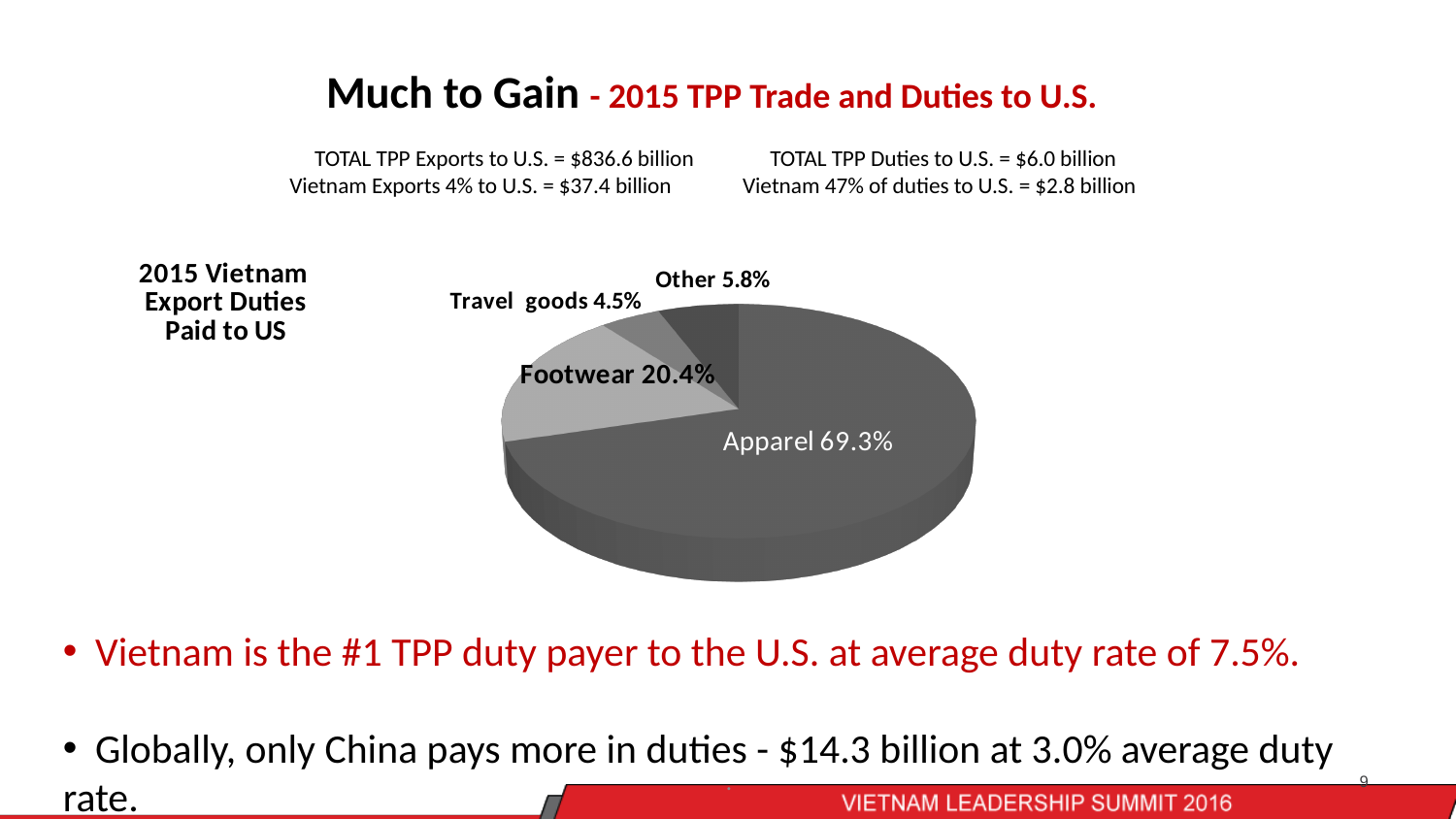
What share of the pie does Other represent? 5.8% What is the title of the pie chart? 2015 Vietnam Export Duties Paid to US What kind of chart is shown on the slide? Pie chart What share of the pie does Apparel represent? 69.3% What is the combined share of Footwear and Travel goods? 24.9% What is the difference in percentage points between Apparel and Footwear? 48.9 Which category has the smallest slice of the pie? Travel goods What share of the pie does Footwear represent? 20.4% What share of the pie does Travel goods represent? 4.5% Which is larger, the Other slice or the Travel goods slice? Other Which category has the largest slice of the pie? Apparel How many slices does the pie chart have? 4